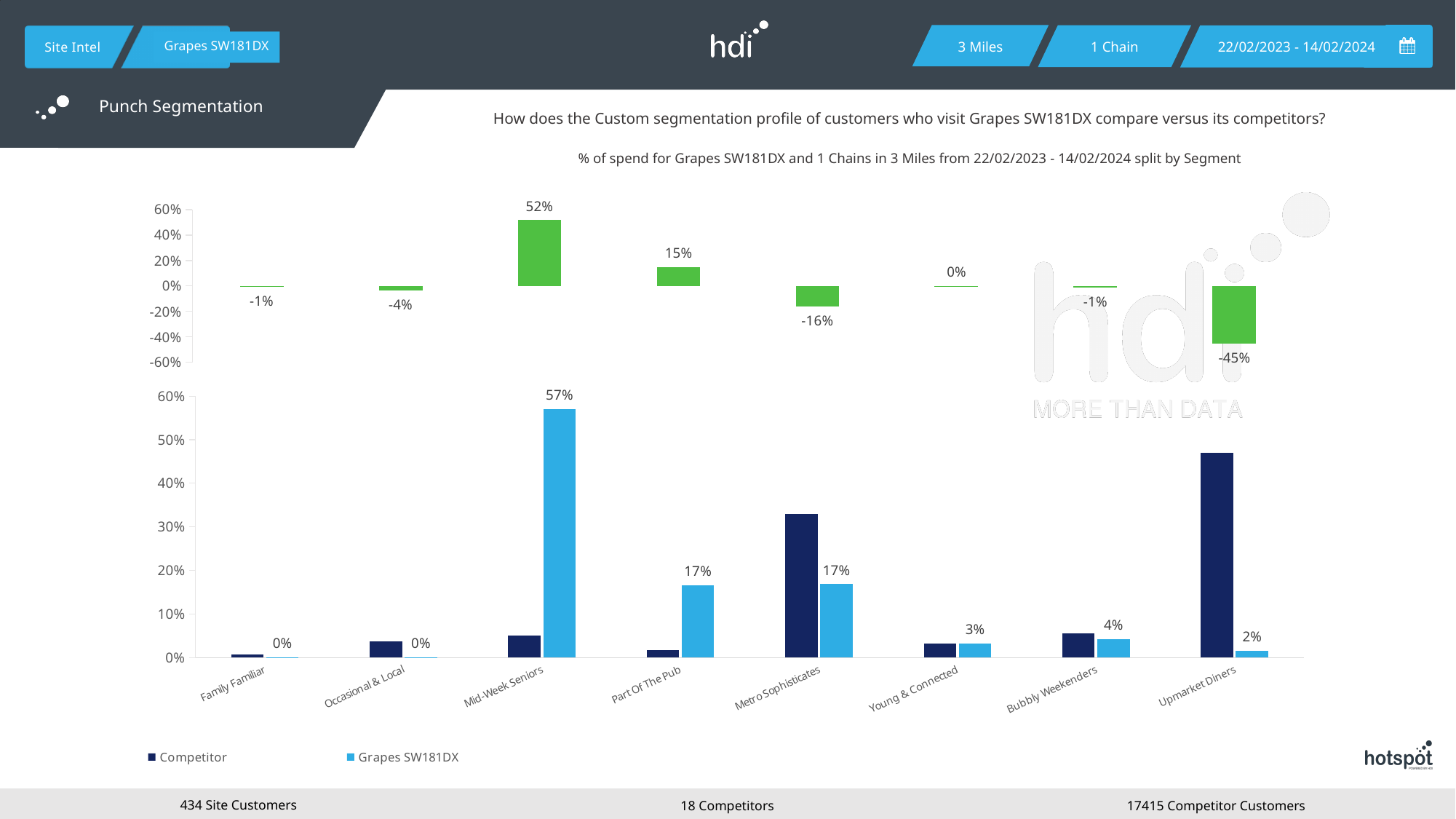
In the bottom chart, what is the difference between the Grapes SW181DX values for Mid-Week Seniors and Part Of The Pub? 40% In the bottom chart, what is the value for Grapes SW181DX in the Mid-Week Seniors segment? 57% In the top chart, what is the value shown for Upmarket Diners? -45% In the bottom chart, is the Competitor value for Upmarket Diners greater or less than 40%? greater In the bottom chart, what is the value for Grapes SW181DX in the Bubbly Weekenders segment? 4% In the top chart, which segment has the highest value? Mid-Week Seniors In the top chart, which segment has the lowest value? Upmarket Diners In the bottom chart, which is larger for Metro Sophisticates: the Competitor value or the Grapes SW181DX value? Competitor In the top chart, what is the value shown for Metro Sophisticates? -16% How many segments are shown on the x axis of the bottom chart? 8 How many series does the legend of the bottom chart list? 2 In the bottom chart, which segment has the lowest Competitor value? Family Familiar